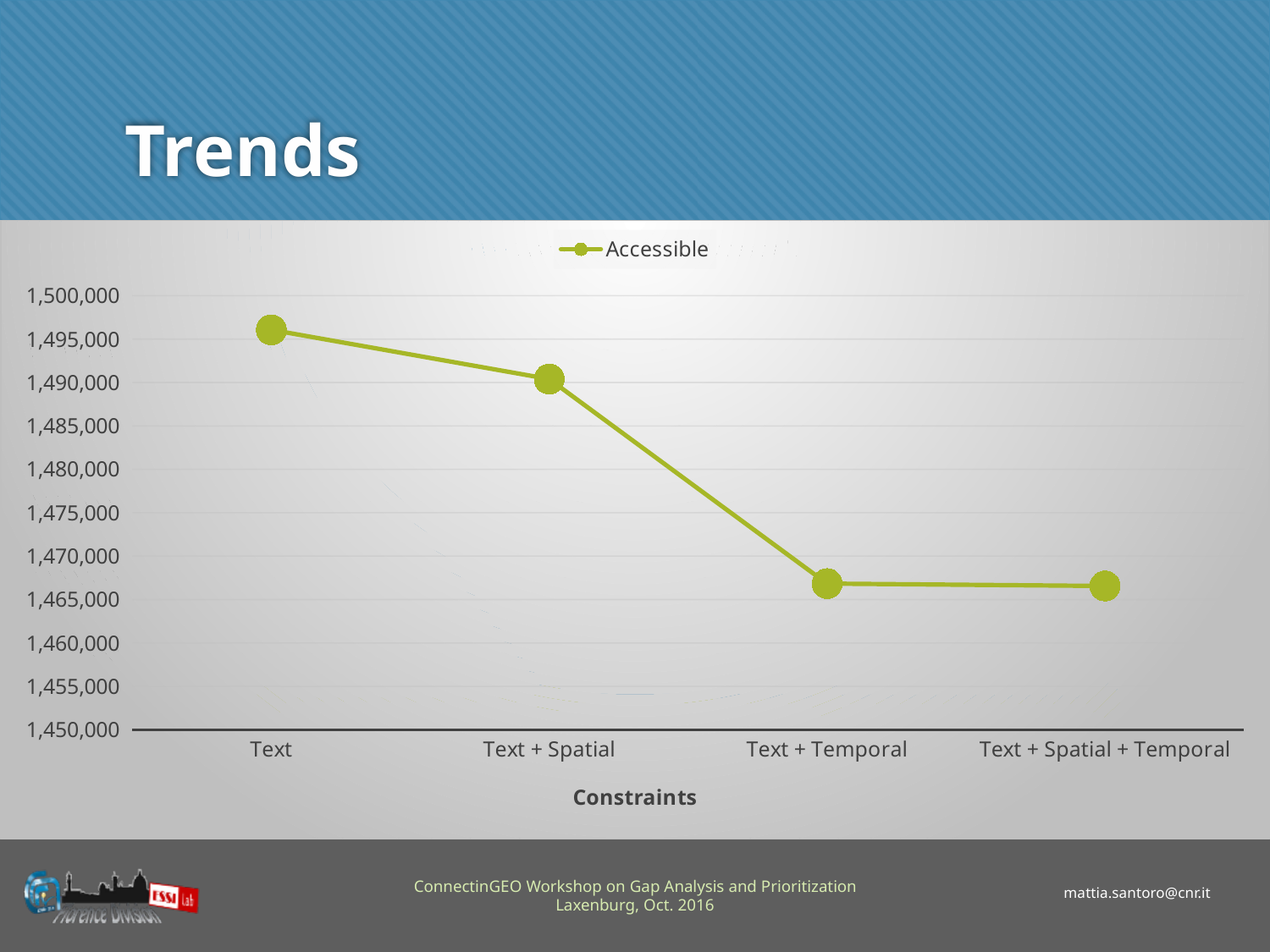
Is the Accessible value for Text greater or less than 1,490,000? greater Is the Accessible value for Text + Temporal greater or less than 1,470,000? less What is the title of the x axis? Constraints Is the Accessible value for Text + Spatial + Temporal greater or less than 1,470,000? less Which has the larger Accessible value, Text + Spatial or Text + Spatial + Temporal? Text + Spatial Do the Accessible values rise or fall moving from Text to Text + Spatial + Temporal along the x axis? fall What kind of chart is shown on the slide? line chart How many series does the legend list? 1 Which constraint has the highest Accessible value? Text How many categories are plotted along the x axis? 4 Which has the larger Accessible value, Text or Text + Temporal? Text